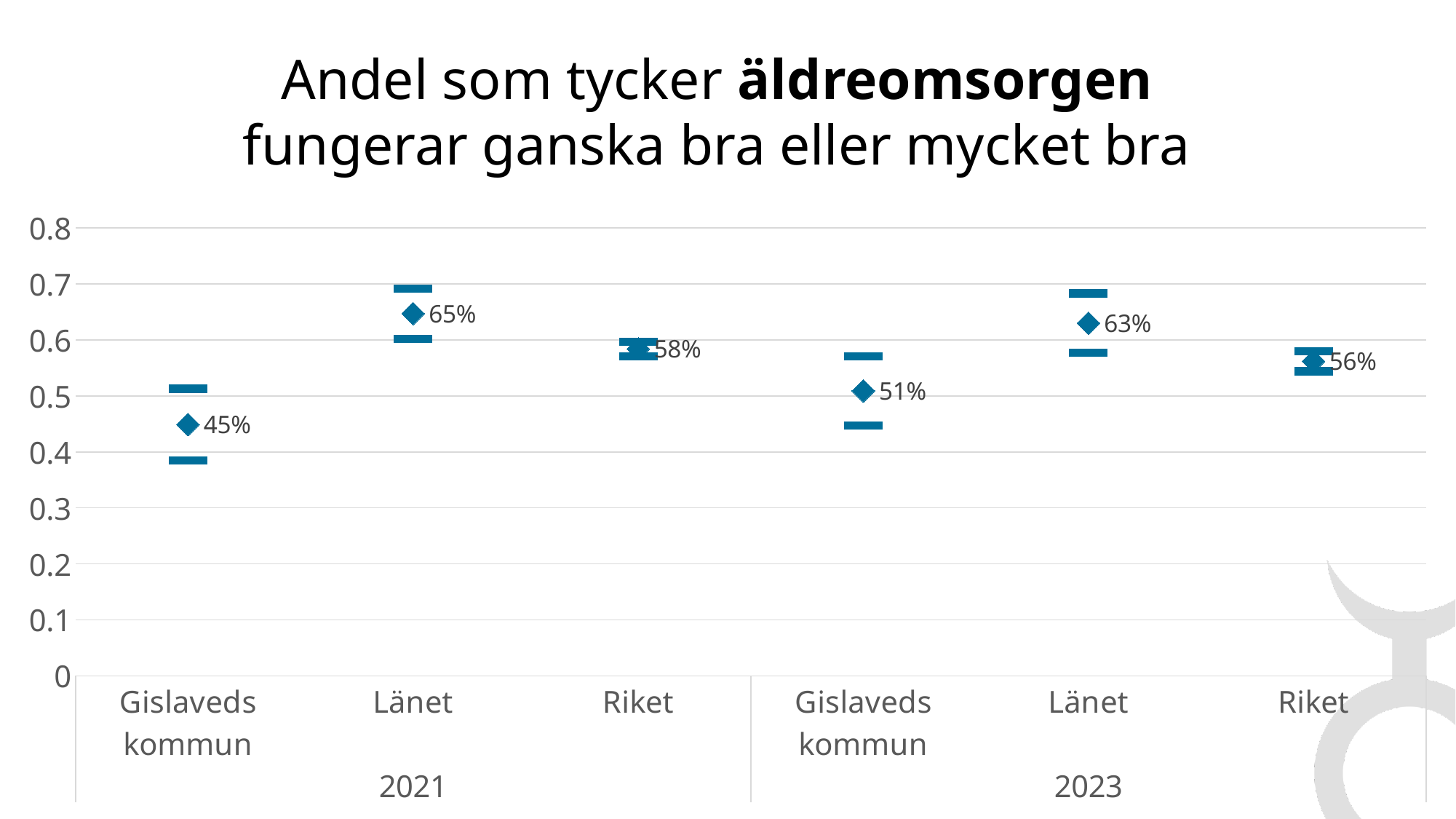
Which category and year has the highest value? Länet 2021 What is the value for Riket in 2021? 58% What is the value for Gislaveds kommun in 2021? 45% Which category and year has the lowest value? Gislaveds kommun 2021 What is the value for Länet in 2023? 63% By how much did the value for Gislaveds kommun change from 2021 to 2023? 6 percentage points Did the value for Gislaveds kommun rise or fall from 2021 to 2023? rise Is the value for Gislaveds kommun in 2021 greater or less than 0.5? less What is the difference between Länet and Gislaveds kommun in 2021? 20 percentage points Which is larger, the value for Riket in 2021 or Riket in 2023? Riket 2021 What is the value for Gislaveds kommun in 2023? 51%